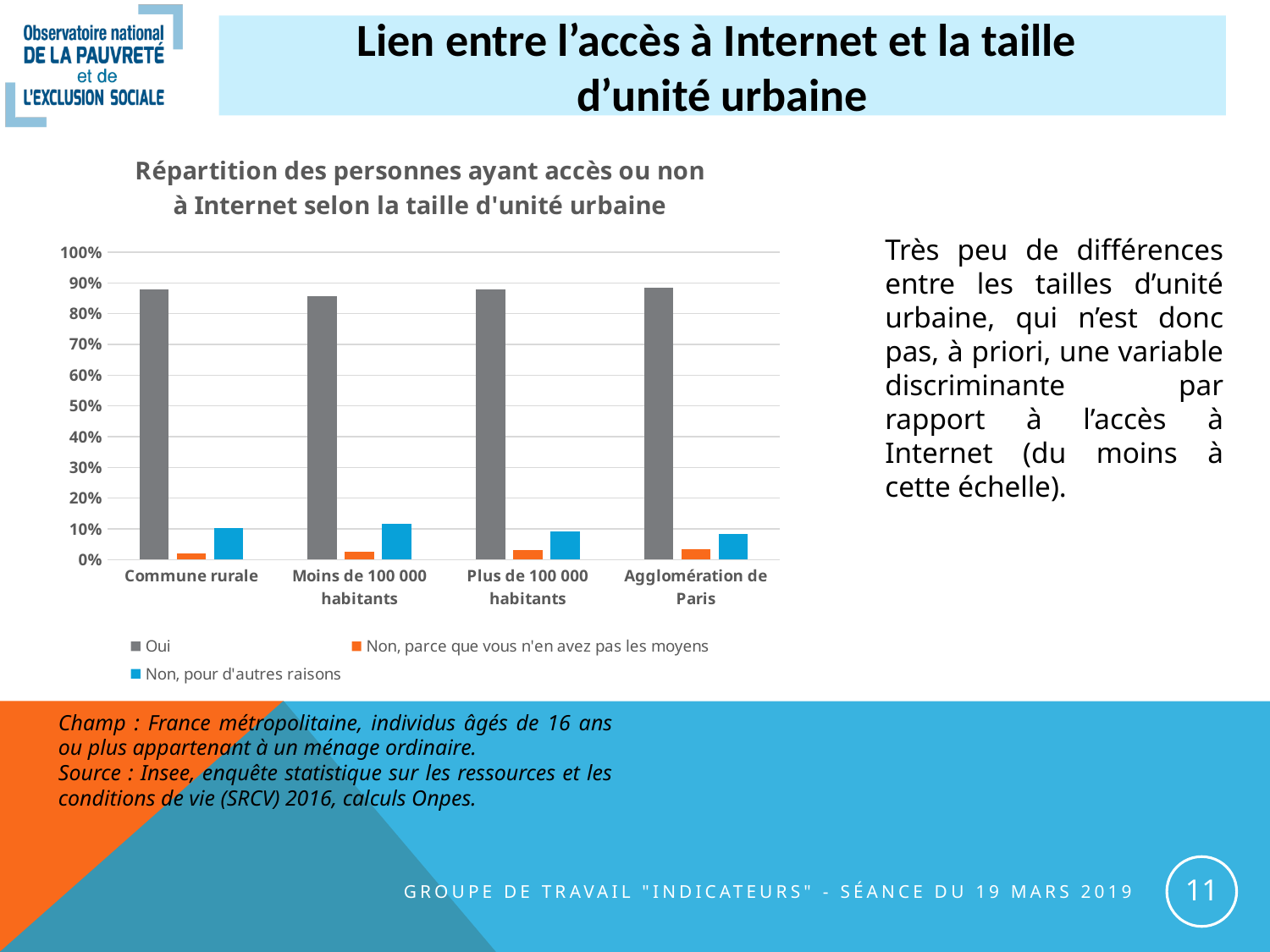
What kind of chart is shown on the slide? bar chart How many categories of urban unit size are shown on the x axis? 4 Is the value for "Non, pour d'autres raisons" in "Agglomération de Paris" greater or less than 20%? less For the series "Non, pour d'autres raisons", which is larger: "Moins de 100 000 habitants" or "Agglomération de Paris"? Moins de 100 000 habitants How many series does the legend list? 3 What is the title of the chart? Répartition des personnes ayant accès ou non à Internet selon la taille d'unité urbaine Which series is shown in grey in the legend? Oui Is the value for "Non, parce que vous n'en avez pas les moyens" in "Commune rurale" greater or less than 10%? less In "Plus de 100 000 habitants", which is larger: "Non, parce que vous n'en avez pas les moyens" or "Non, pour d'autres raisons"? Non, pour d'autres raisons Is the value for "Oui" in "Commune rurale" greater or less than 80%? greater In "Commune rurale", which is larger: "Oui" or "Non, pour d'autres raisons"? Oui